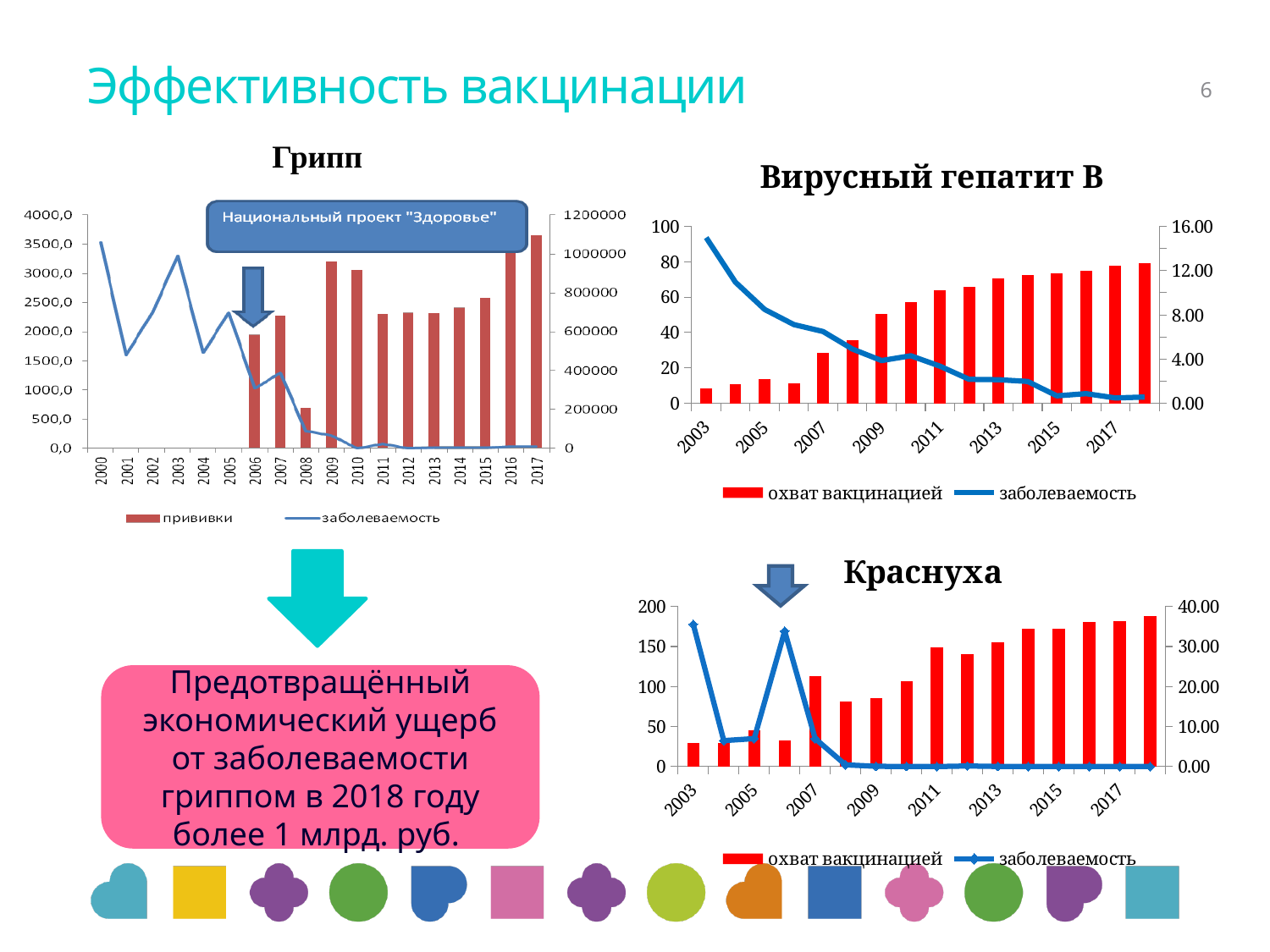
On the "Вирусный гепатит В" chart, does the заболеваемость line rise or fall from 2003 to 2018? fall How many years are shown on the x axis of the "Грипп" chart? 18 On the "Краснуха" chart, is the bar for 2003 greater or less than 50? less On the "Вирусный гепатит В" chart, is the заболеваемость line value for 2003 greater or less than 12.00 on the right axis? greater On the "Грипп" chart, which bar is taller, 2008 or 2009? 2009 How many series does the legend of the "Краснуха" chart list? 2 What are the two legend entries on the "Грипп" chart? прививки and заболеваемость On the "Вирусный гепатит В" chart, is the bar for 2013 greater or less than 60? greater What kind of chart is the "Вирусный гепатит В" chart? Combined bar and line chart On the "Краснуха" chart, which bar is taller, 2007 or 2008? 2007